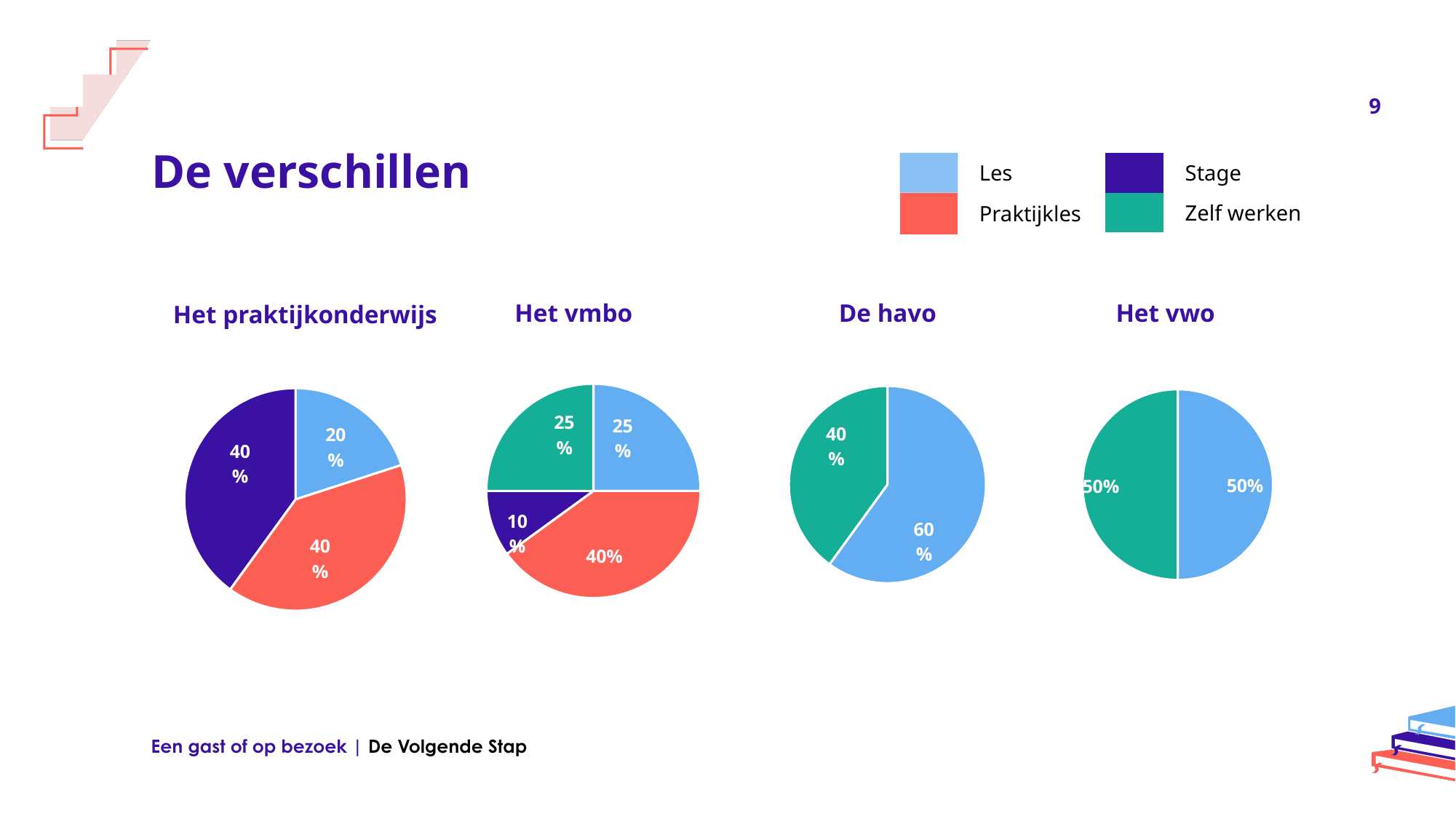
In the 'Het praktijkonderwijs' chart, what share is Les? 20% How many slices does the 'Het vmbo' chart have? 4 How many categories does the shared legend list? 4 In the 'De havo' chart, what share is Les? 60% In the 'Het vmbo' chart, which category has the smallest slice? Stage In the 'Het vmbo' chart, is the Les slice or the Praktijkles slice larger? Praktijkles In the 'Het vmbo' chart, what share is Stage? 10% In the 'Het vmbo' chart, which category has the largest slice? Praktijkles In the 'De havo' chart, what is the difference between the Les and Zelf werken shares? 20% In the 'Het vwo' chart, what share is Zelf werken? 50% What kind of chart is used for 'De havo'? Pie chart In the 'Het praktijkonderwijs' chart, which category has the smallest slice? Les